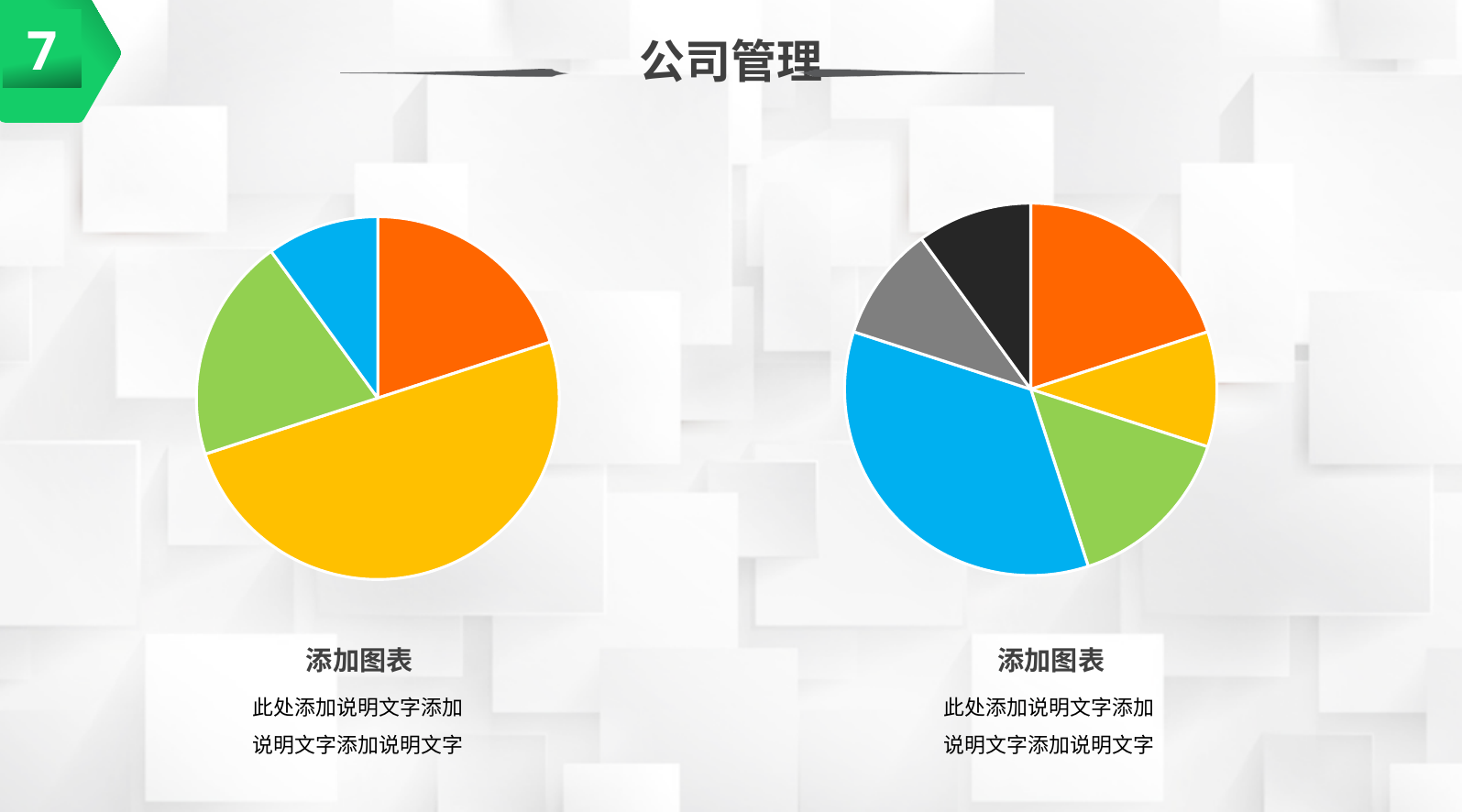
In the pie chart on the left of the slide, which colour slice is the smallest? blue What kind of chart is the chart on the left of the slide? pie chart In the pie chart on the left of the slide, which is larger, the orange slice or the blue slice? orange In the pie chart on the left of the slide, which colour slice is the largest? yellow In the pie chart on the right of the slide, which colour slice is the largest? blue In the pie chart on the right of the slide, which is larger, the blue slice or the orange slice? blue In the pie chart on the right of the slide, which is larger, the blue slice or the gray slice? blue How many slices does the pie chart on the left of the slide have? 4 How many slices does the pie chart on the right of the slide have? 6 What kind of chart is the chart on the right of the slide? pie chart What is the title shown at the top of the slide? 公司管理 What caption appears below each pie chart on the slide? 添加图表